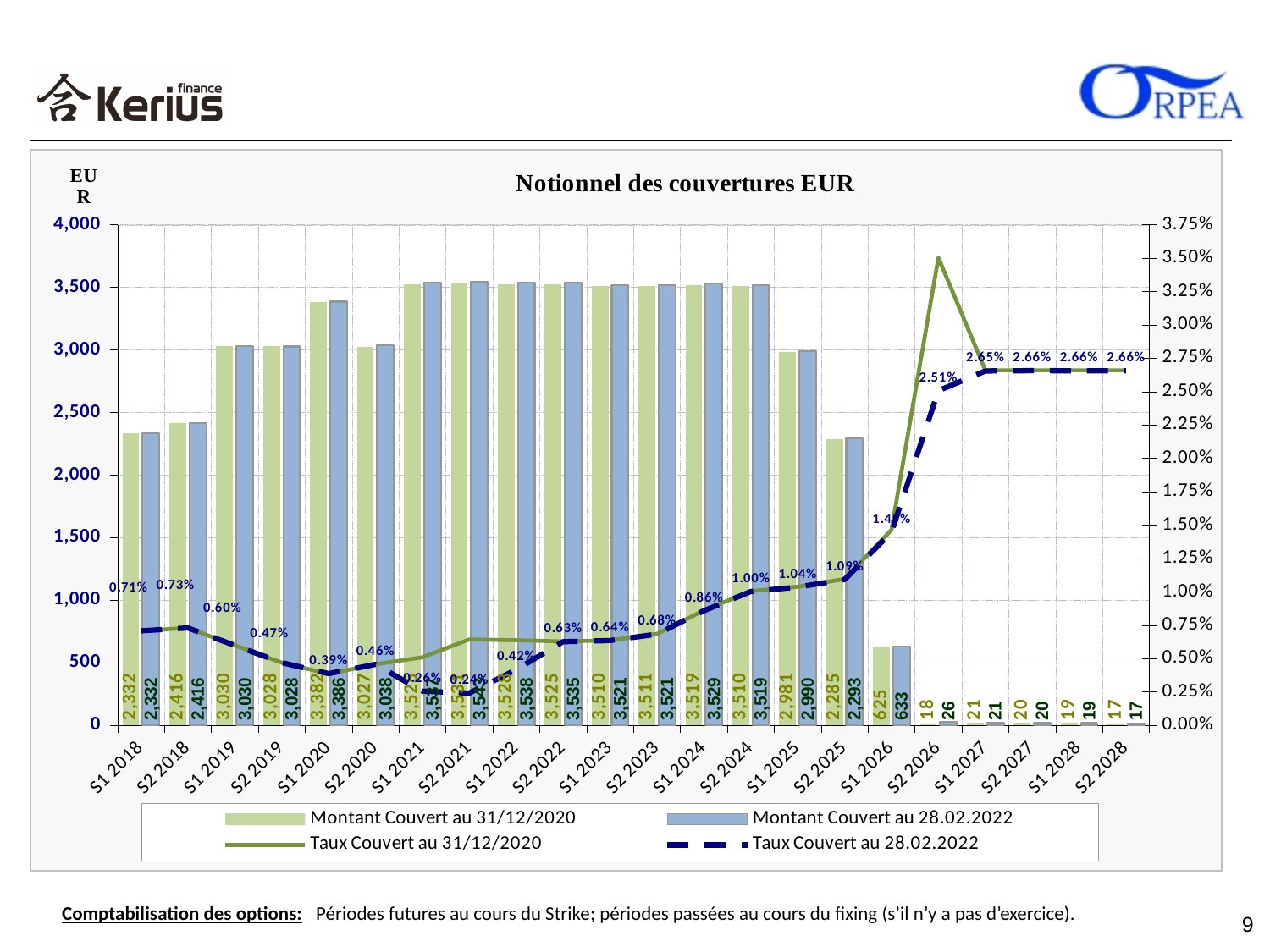
What kind of chart is shown on the slide? Combination bar and line chart What is the Taux Couvert au 28.02.2022 for S2 2026? 2.51% What is the difference between the Montant Couvert au 28.02.2022 and the Montant Couvert au 31/12/2020 for S1 2025? 9 How many series does the legend list? 4 What is the title of the chart? Notionnel des couvertures EUR Is the Montant Couvert au 31/12/2020 for S1 2020 greater or less than 3,000? greater What is the Montant Couvert au 28.02.2022 for S2 2028? 17 Which period has the lowest labelled Taux Couvert au 28.02.2022? S2 2021 Which is larger, the Montant Couvert au 28.02.2022 for S1 2026 or for S2 2026? S1 2026 What is the Montant Couvert au 28.02.2022 for S1 2020? 3,386 How many periods are shown on the x axis? 22 What is the Montant Couvert au 31/12/2020 for S2 2025? 2,285